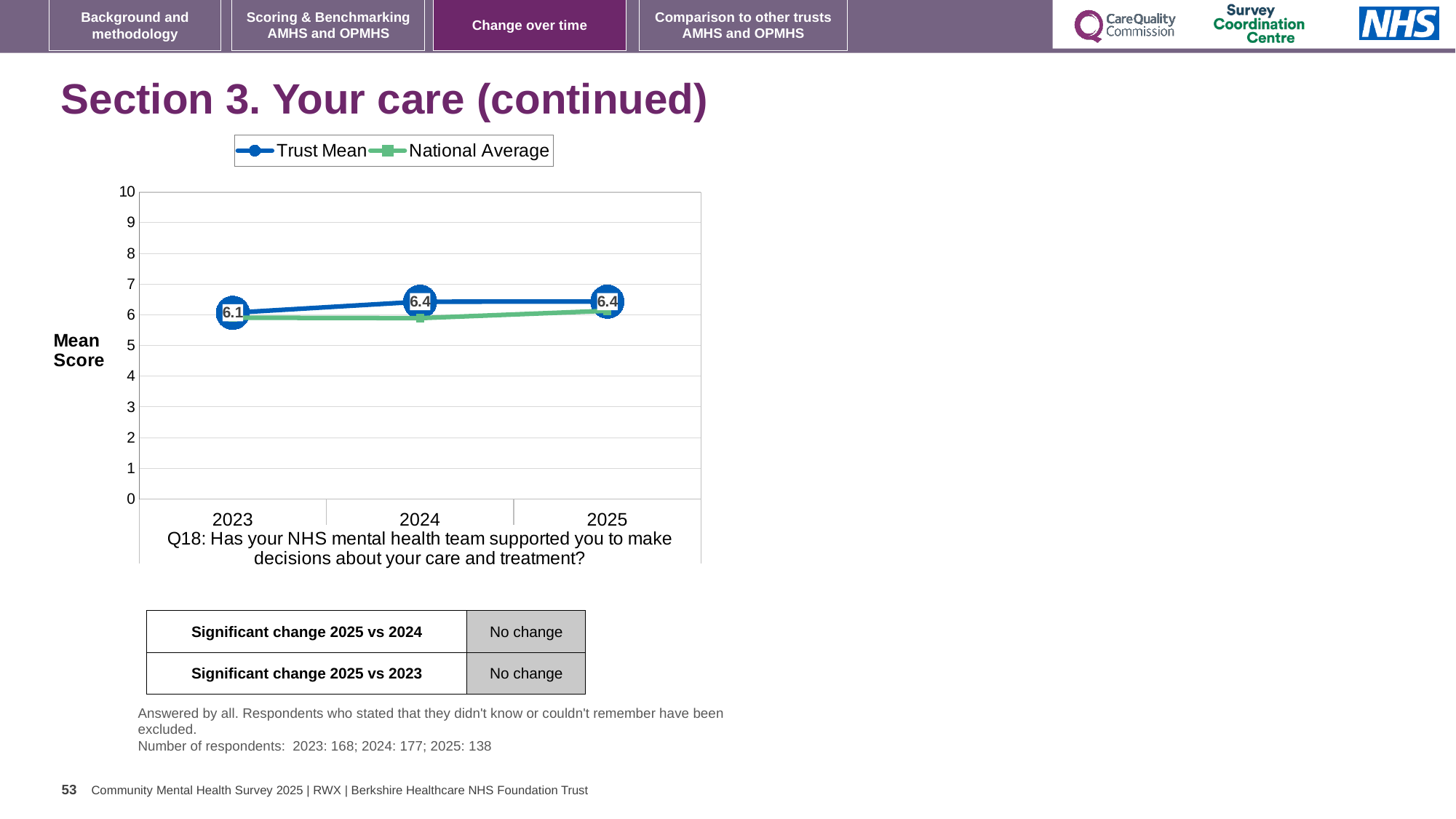
What is the Trust Mean value for 2025? 6.4 By how much did the Trust Mean change from 2023 to 2024? 0.3 What is the Trust Mean value for 2024? 6.4 What is the Trust Mean value for 2023? 6.1 What kind of chart is shown on the slide? Line chart Is the National Average value for 2023 greater or less than 7? less Does the Trust Mean rise or fall from 2023 to 2025? Rise How many years are plotted on the x axis? 3 In 2025, which is higher: the Trust Mean or the National Average? Trust Mean What is the label on the y axis of the chart? Mean Score How many series does the legend list? 2 In which year is the Trust Mean lowest? 2023